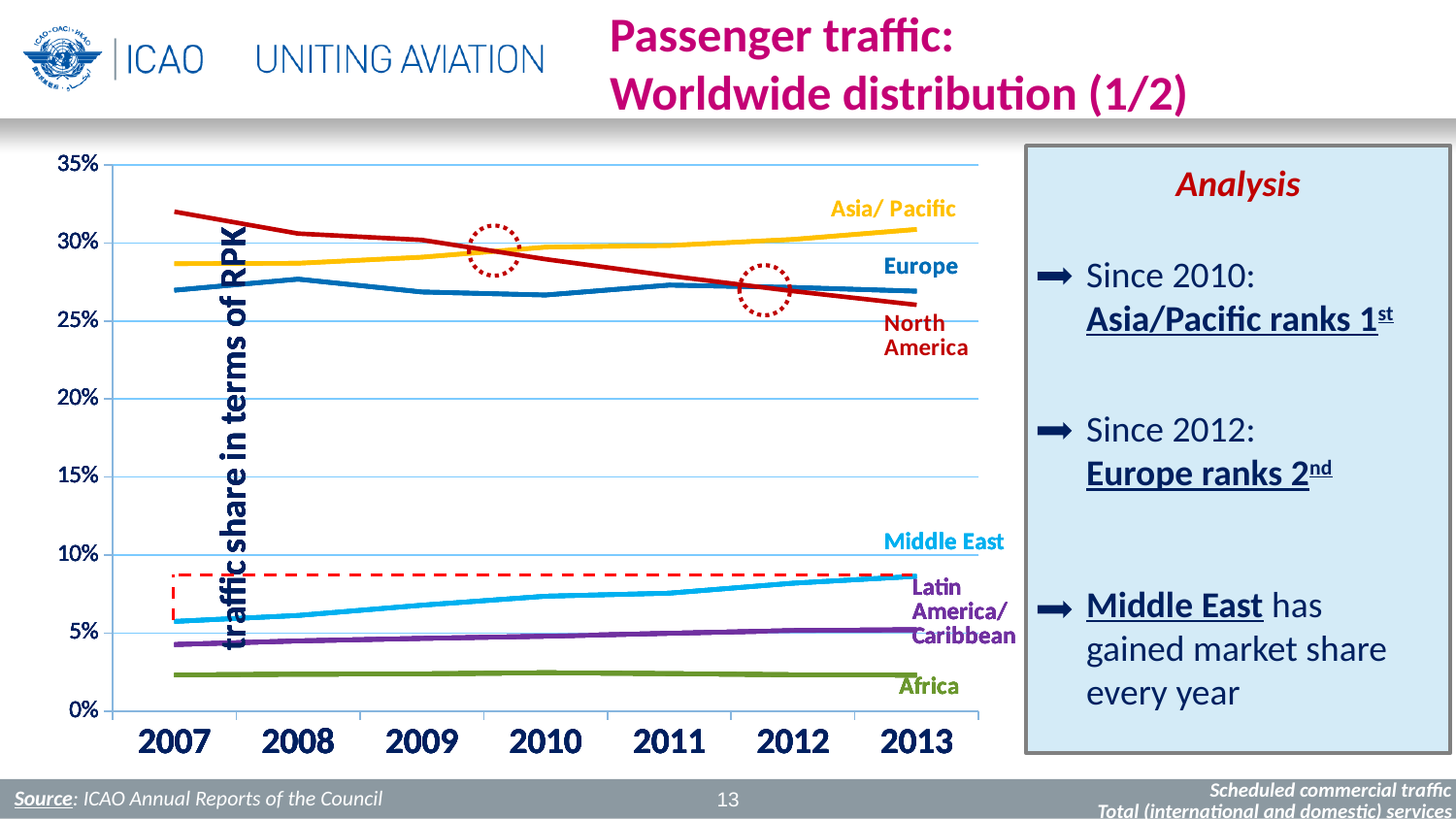
Which region has the highest share in 2013? Asia/Pacific Is the value for Africa in 2013 greater or less than 5%? less Does the Middle East line rise or fall from 2007 to 2013? rise Is the value for North America in 2007 greater or less than 30%? greater What kind of chart is shown on the slide? line chart In 2007, which has the larger share: North America or Asia/Pacific? North America Does the Asia/Pacific line rise or fall from 2007 to 2013? rise Does the North America line rise or fall from 2007 to 2013? fall How many years are shown along the x axis of the chart? 7 How many regions are plotted as lines on the chart? 6 Which region has the lowest share in 2013? Africa What is the label on the vertical axis of the chart? traffic share in terms of RPK